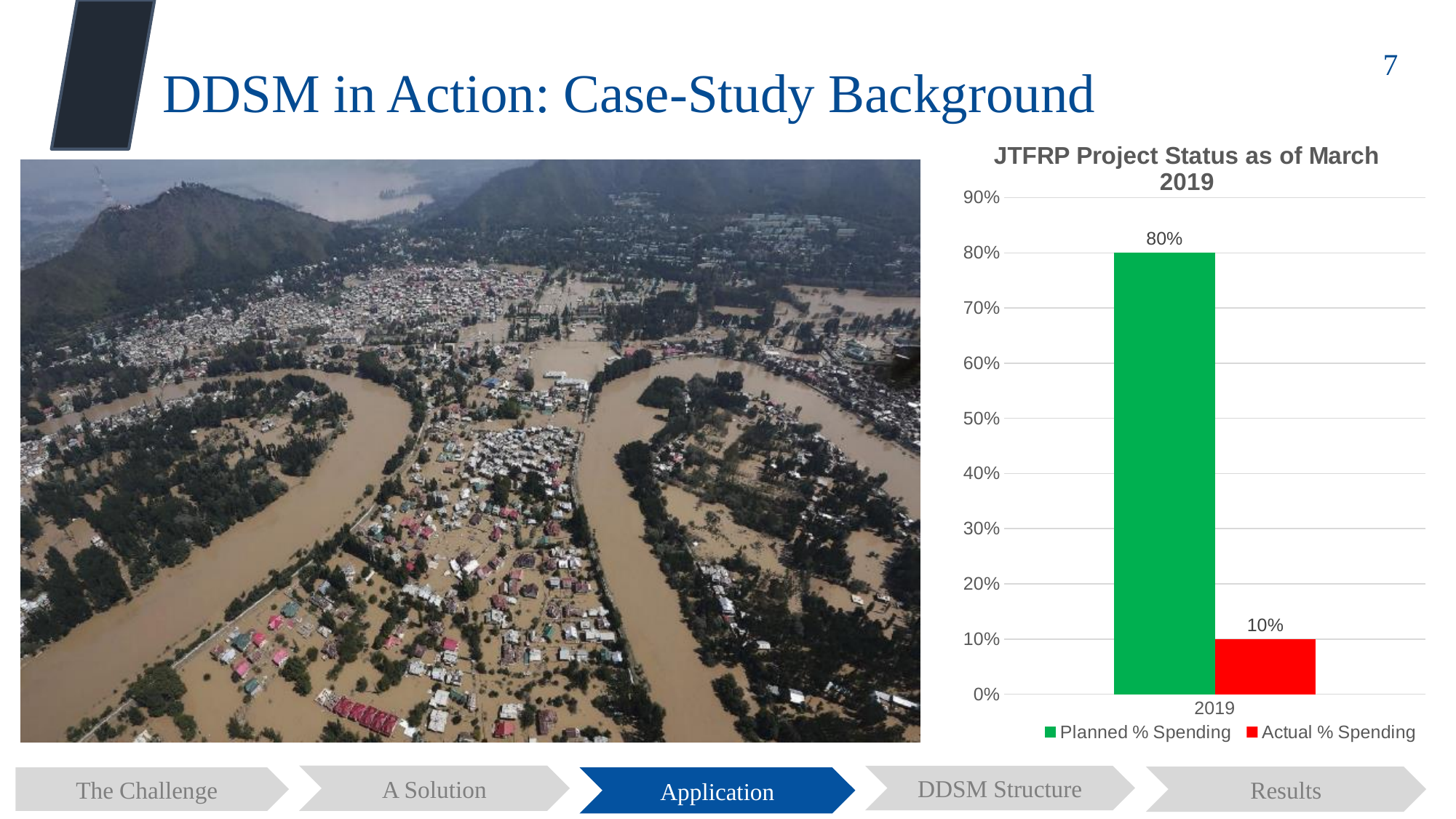
How many categories are shown on the x axis? 1 What is the difference between Planned % Spending and Actual % Spending for 2019? 70% What colour is the Actual % Spending bar? Red Is the Actual % Spending value for 2019 greater or less than 20%? less What is the Actual % Spending value for 2019? 10% What is the title of the chart? JTFRP Project Status as of March 2019 What is the Planned % Spending value for 2019? 80% Which series has the lowest value in the chart? Actual % Spending How many series does the legend list? 2 Is the Planned % Spending value for 2019 greater or less than 50%? greater Which series has the higher value for 2019, Planned % Spending or Actual % Spending? Planned % Spending What kind of chart is shown on the slide? Bar chart